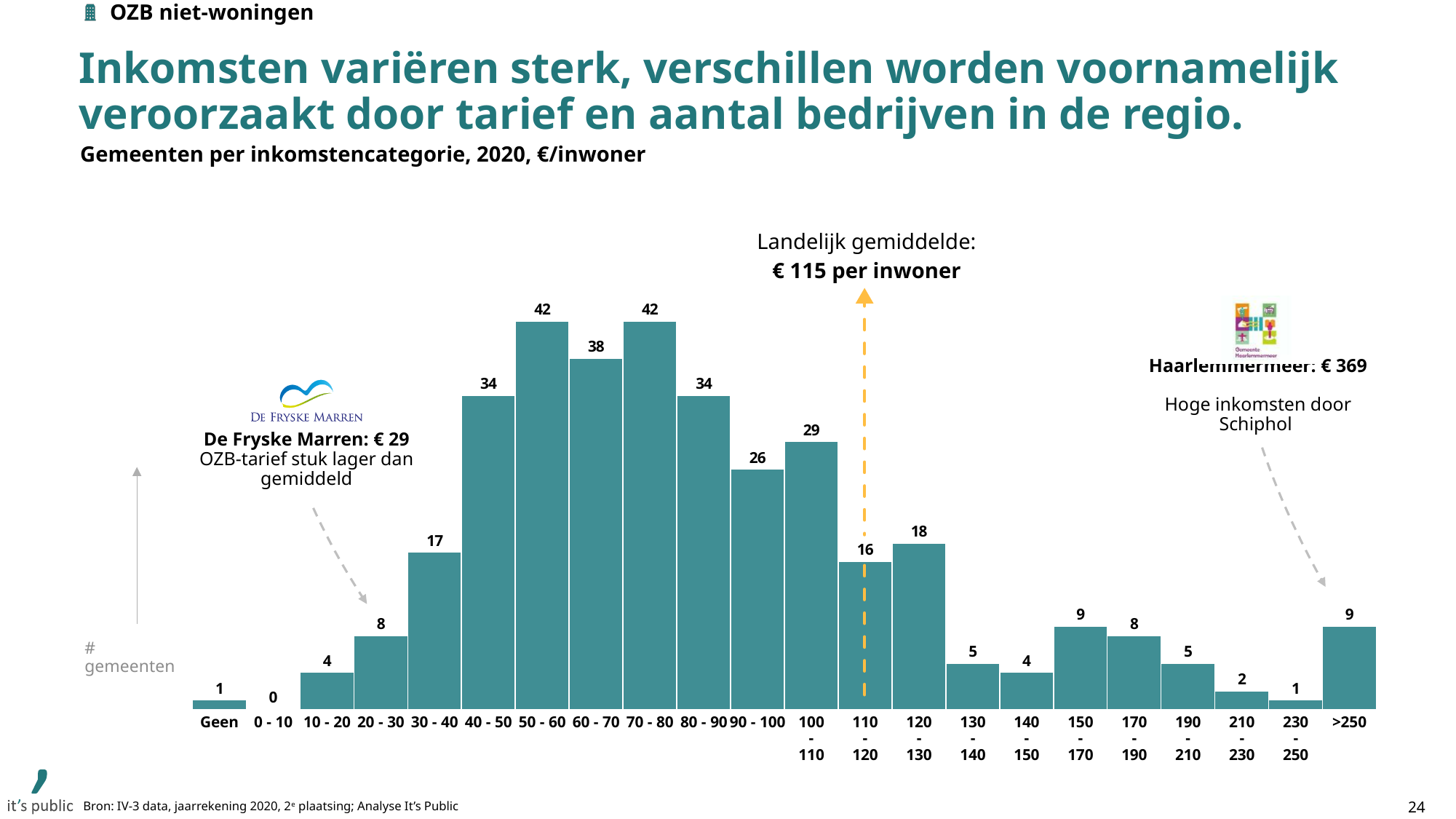
How many municipalities are in the >250 category? 9 What is the highest number of municipalities shown for any single category? 42 What is the value for the 'Geen' category? 1 Which has more municipalities: the 100 - 110 category or the 120 - 130 category? 100 - 110 What type of chart is shown on the slide? Bar chart How many income categories are shown on the x axis? 22 How many municipalities fall in the 50 - 60 €/inwoner category? 42 Which income category has the lowest number of municipalities? 0 - 10 What is the value shown for the 110 - 120 category? 16 What value is annotated for Haarlemmermeer? € 369 What is the national average (Landelijk gemiddelde) indicated by the dashed line? € 115 per inwoner What is the difference between the values for 60 - 70 and 90 - 100? 12